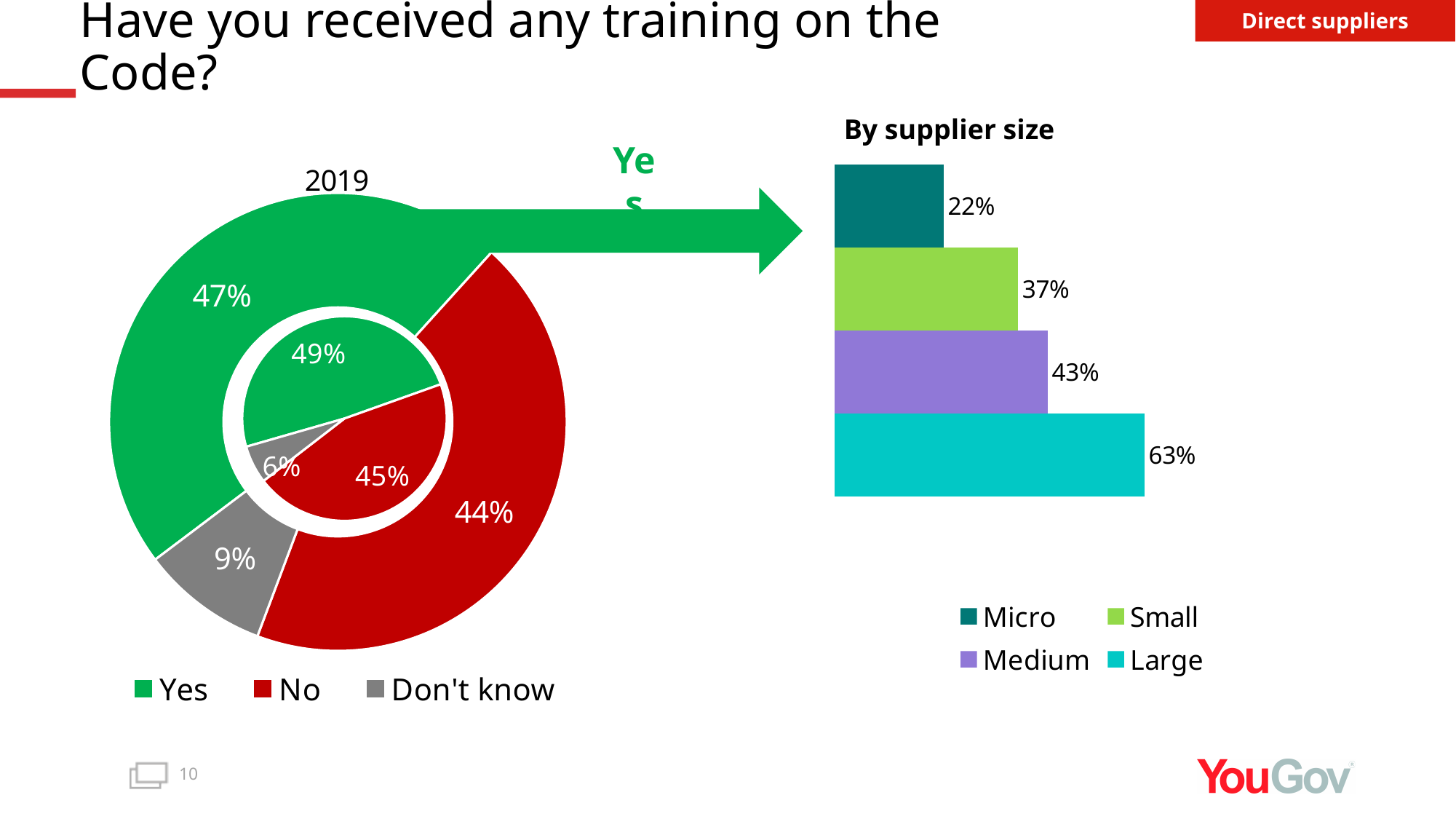
What kind of chart is the 'By supplier size' chart? Bar chart How many entries does the legend of the 'By supplier size' bar chart list? 4 In the 'By supplier size' bar chart, which supplier size has the highest value? Large In the donut chart, what is the 'No' value shown on the inner ring? 45% In the 'By supplier size' bar chart, what is the value for Micro suppliers? 22% In the donut chart, what share of the outer 2019 ring is 'Yes'? 47% In the 'By supplier size' bar chart, what is the value for Large suppliers? 63% In the donut chart, what share of the outer 2019 ring is 'Don't know'? 9% In the 'By supplier size' bar chart, which is larger: the value for Medium or the value for Small? Medium In the 'By supplier size' bar chart, which supplier size has the lowest value? Micro In the 'By supplier size' bar chart, what is the difference between the Large and Small values? 26% How many categories does the legend of the donut chart list? 3